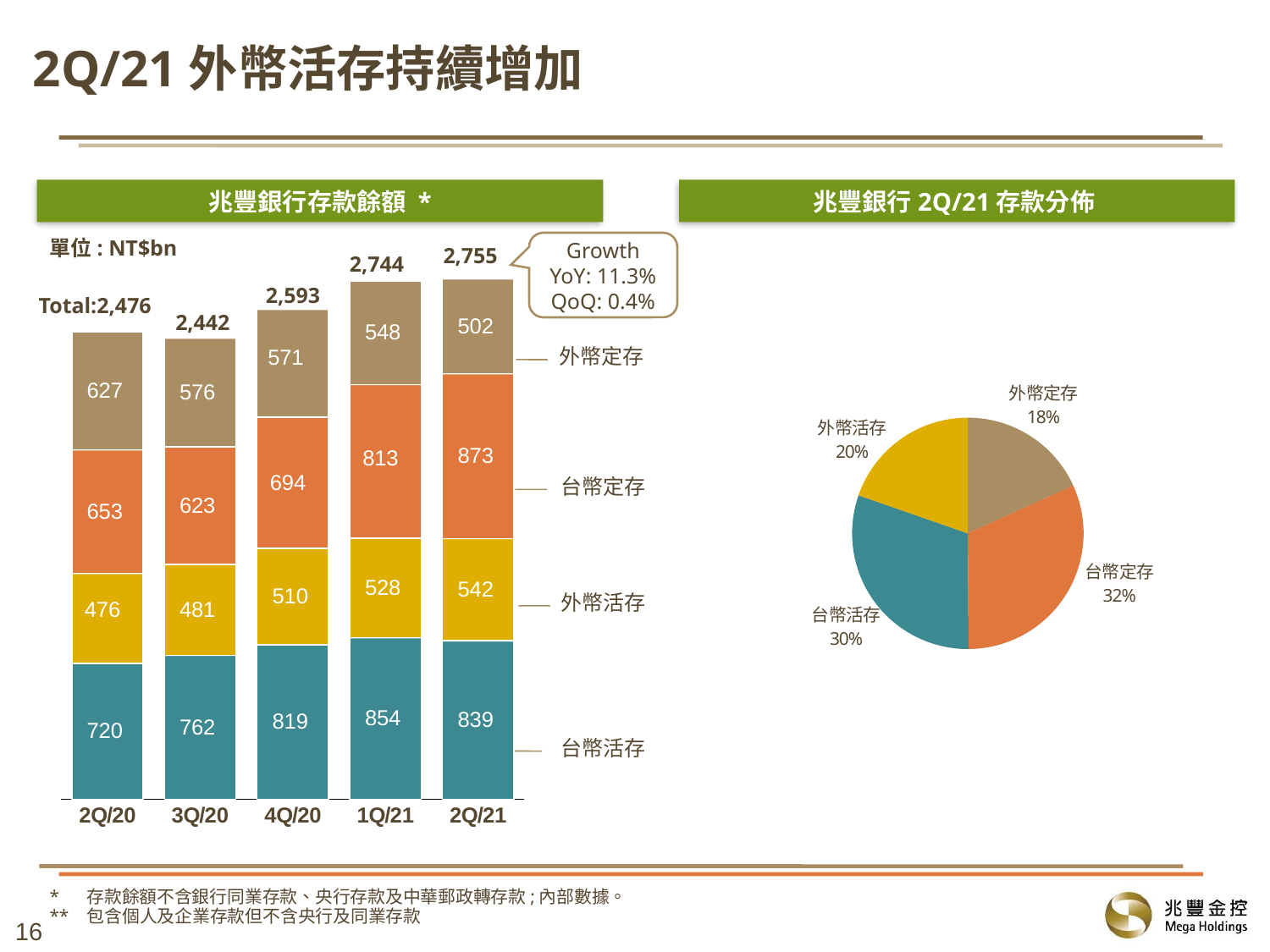
In the 兆豐銀行 2Q/21 存款分佈 pie chart, which category has the smallest slice? 外幣定存 In the 兆豐銀行存款餘額 chart, which quarter has the highest total deposit balance? 2Q/21 In the 兆豐銀行存款餘額 chart, does 外幣活存 rise or fall from 2Q/20 to 2Q/21? Rise What kind of chart is the 兆豐銀行存款餘額 chart? Stacked bar chart In the 兆豐銀行存款餘額 chart, how many quarters are shown on the x axis? 5 In the 兆豐銀行存款餘額 chart, what is the total of the stacked bar for 1Q/21? 2,744 In the 兆豐銀行存款餘額 chart, which quarter has the lowest total deposit balance? 3Q/20 In the 兆豐銀行存款餘額 chart, by how much did 台幣定存 increase from 1Q/21 to 2Q/21? 60 In the 兆豐銀行存款餘額 chart, is 外幣活存 larger in 2Q/20 or 3Q/20? 3Q/20 In the 兆豐銀行 2Q/21 存款分佈 pie chart, what share does 台幣定存 have? 32% In the 兆豐銀行存款餘額 chart, what is the value of 台幣活存 for 2Q/21? 839 In the 兆豐銀行存款餘額 chart, what is the value of 外幣定存 for 4Q/20? 571